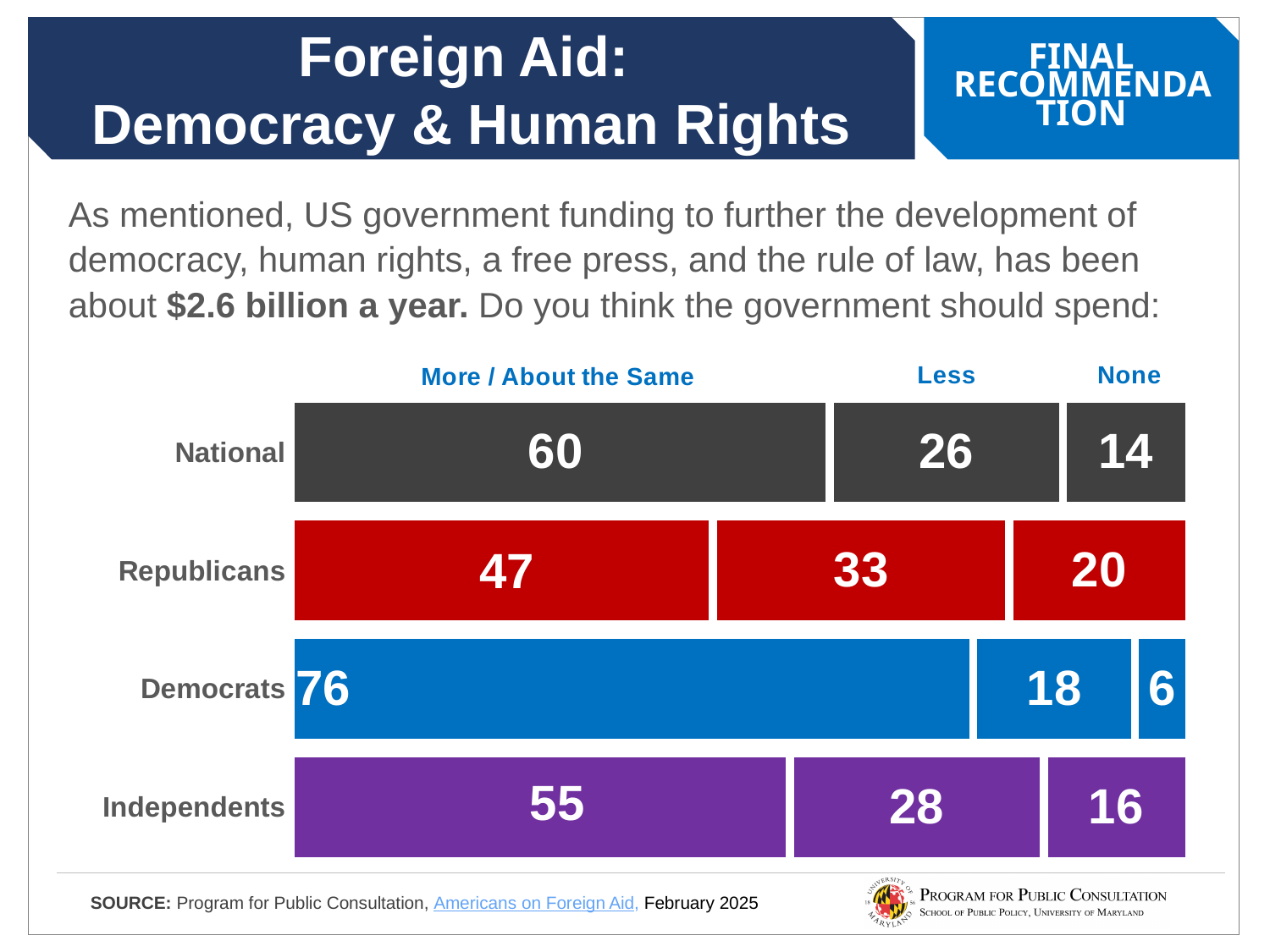
How many groups are shown in the chart? 4 What is the value for Republicans in the Less category? 33 What is the value for National in the More / About the Same category? 60 What is the value for Democrats in the None category? 6 What is the difference between the Republicans and Democrats values for More / About the Same? 29 Which group has the lowest value for None? Democrats Which group has the highest value for More / About the Same? Democrats What is the total of the three values in the Independents bar? 99 Which is larger: the Less value for Republicans or the Less value for Independents? Republicans What is the value for Independents in the Less category? 28 What kind of chart is shown on the slide? Stacked bar chart How many response categories are shown in the chart? 3